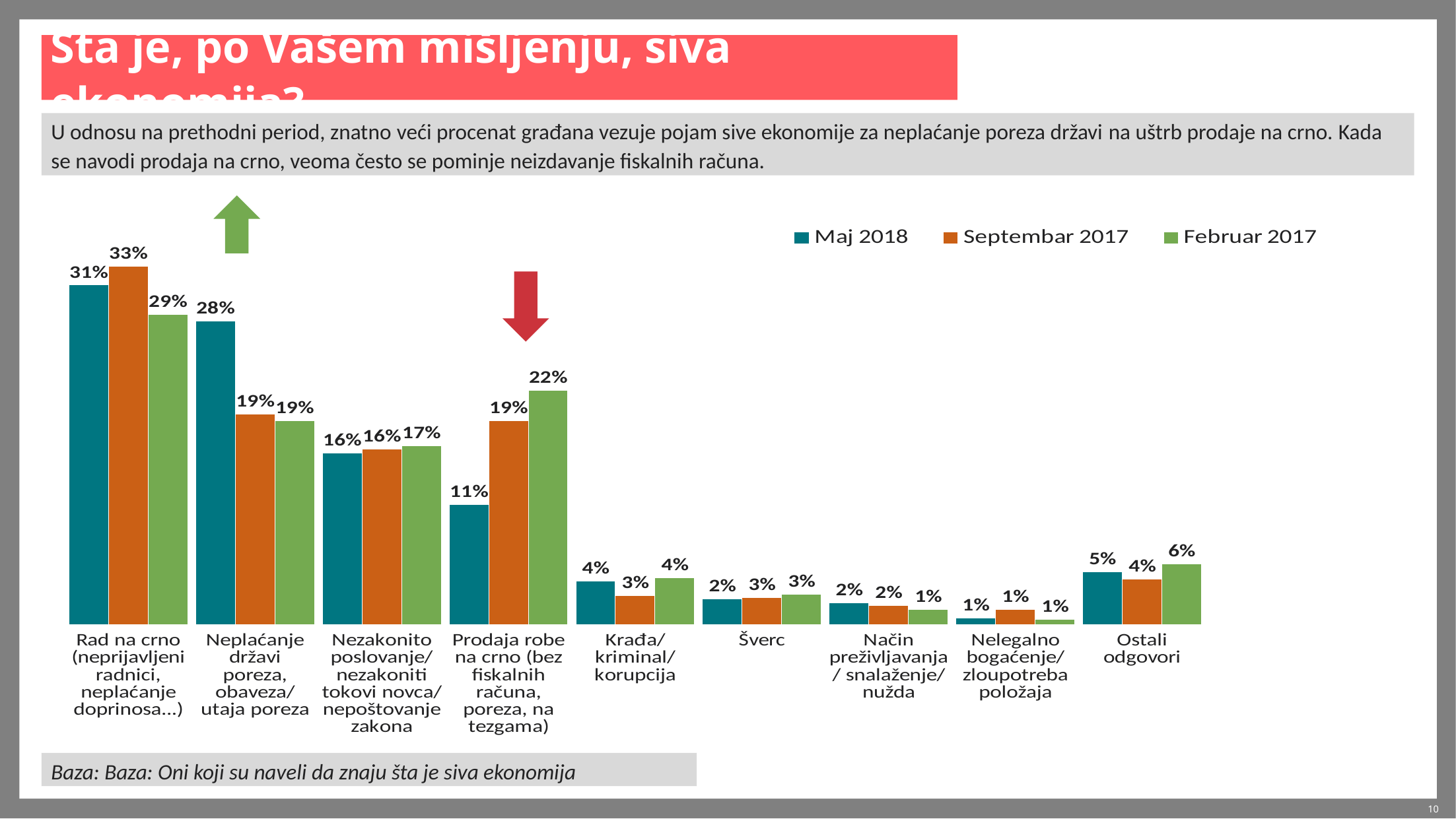
What is the Septembar 2017 value for "Rad na crno (neprijavljeni radnici, neplaćanje doprinosa...)"? 33% What is the difference between the Februar 2017 and Maj 2018 values for "Prodaja robe na crno (bez fiskalnih računa, poreza, na tezgama)"? 11% What is the difference between the Maj 2018 and Septembar 2017 values for "Neplaćanje državi poreza, obaveza/ utaja poreza"? 9% How many categories are shown on the x axis? 9 What kind of chart is shown on the slide? Bar chart What is the Maj 2018 value for "Neplaćanje državi poreza, obaveza/ utaja poreza"? 28% What is the Februar 2017 value for "Prodaja robe na crno (bez fiskalnih računa, poreza, na tezgama)"? 22% For "Ostali odgovori", which series has the larger value: Maj 2018 or Februar 2017? Februar 2017 Which category has the highest Maj 2018 value? Rad na crno (neprijavljeni radnici, neplaćanje doprinosa...) How many series does the legend list? 3 Which series is shown in orange in the legend? Septembar 2017